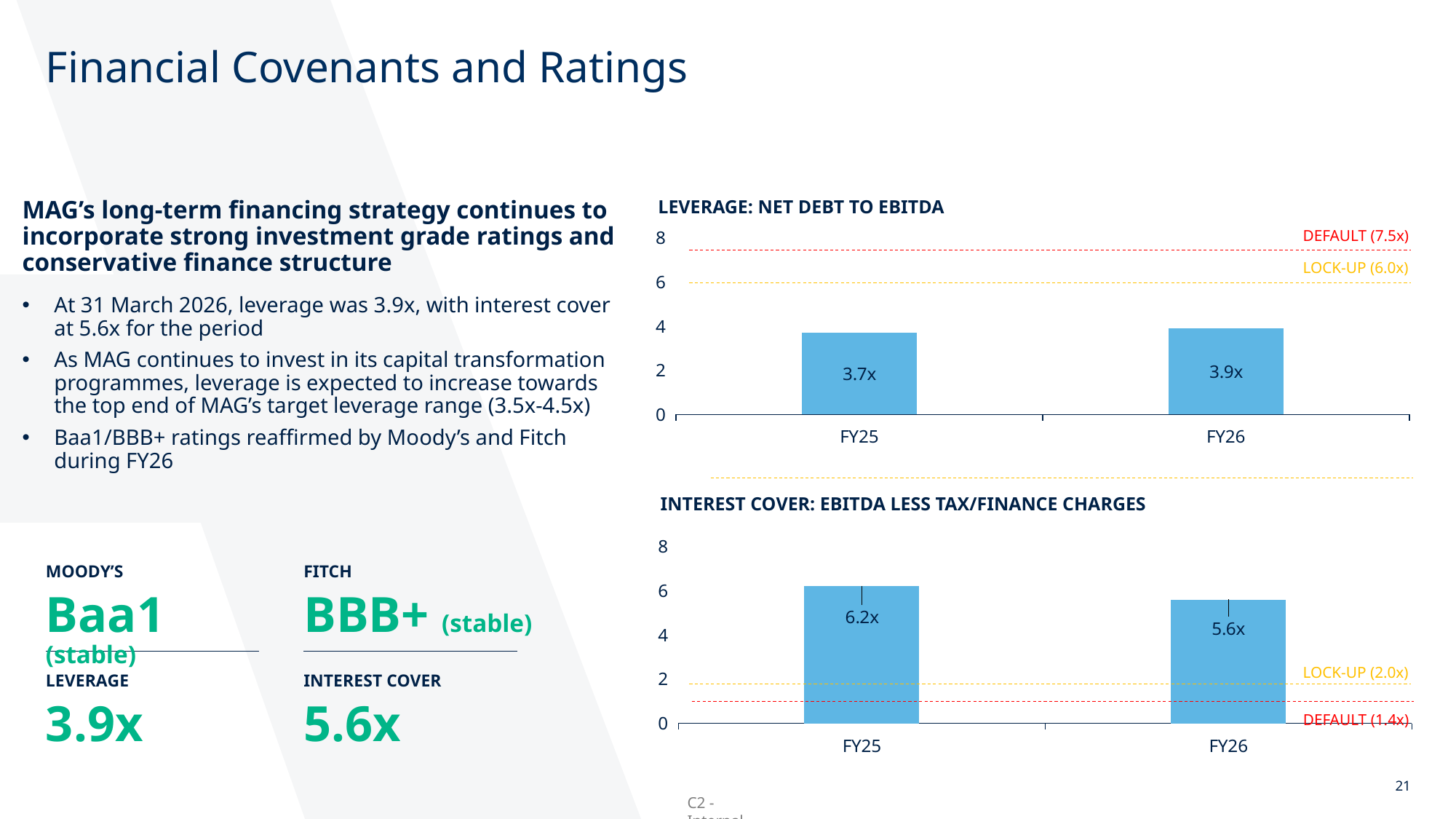
In the 'Interest Cover: EBITDA less Tax/Finance Charges' chart, which year has the lower value? FY26 What kind of chart is the 'Interest Cover: EBITDA less Tax/Finance Charges' chart? bar chart How many categories are shown on the x axis of the 'Leverage: Net Debt to EBITDA' chart? 2 In the 'Interest Cover: EBITDA less Tax/Finance Charges' chart, what is the value for FY26? 5.6x In the 'Leverage: Net Debt to EBITDA' chart, what is the value for FY25? 3.7x In the 'Leverage: Net Debt to EBITDA' chart, what is the value for FY26? 3.9x In the 'Interest Cover: EBITDA less Tax/Finance Charges' chart, what is the value for FY25? 6.2x In the 'Leverage: Net Debt to EBITDA' chart, is the value for FY26 greater or less than 6? less In the 'Interest Cover: EBITDA less Tax/Finance Charges' chart, what is the difference between the FY25 and FY26 values? 0.6x In the 'Leverage: Net Debt to EBITDA' chart, which year has the higher value? FY26 In the 'Leverage: Net Debt to EBITDA' chart, what is the difference between the FY26 and FY25 values? 0.2x In the 'Interest Cover: EBITDA less Tax/Finance Charges' chart, do the values rise or fall from FY25 to FY26? fall